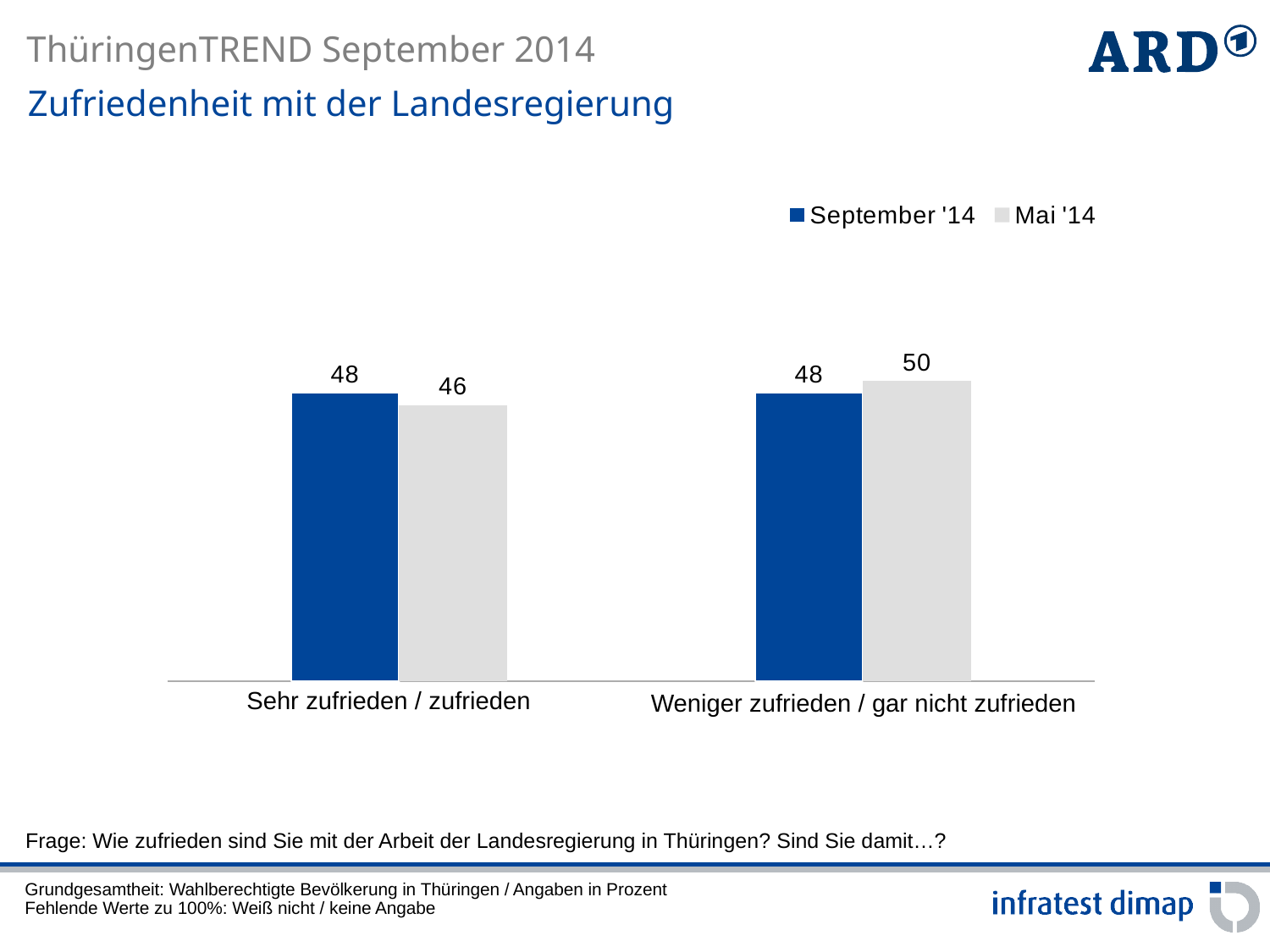
How many categories are shown on the x axis? 2 Which category has the lowest value in the Mai '14 series? Sehr zufrieden / zufrieden What is the difference between the September '14 and Mai '14 values for 'Sehr zufrieden / zufrieden'? 2 What is the value for 'Weniger zufrieden / gar nicht zufrieden' in the September '14 series? 48 What is the value for 'Sehr zufrieden / zufrieden' in the September '14 series? 48 What is the value for 'Sehr zufrieden / zufrieden' in the Mai '14 series? 46 How many series does the legend list? 2 Which category has the highest value in the Mai '14 series? Weniger zufrieden / gar nicht zufrieden For 'Sehr zufrieden / zufrieden', which series has the larger value, September '14 or Mai '14? September '14 What is the difference between the Mai '14 and September '14 values for 'Weniger zufrieden / gar nicht zufrieden'? 2 What kind of chart is shown on the slide? Bar chart What is the value for 'Weniger zufrieden / gar nicht zufrieden' in the Mai '14 series? 50